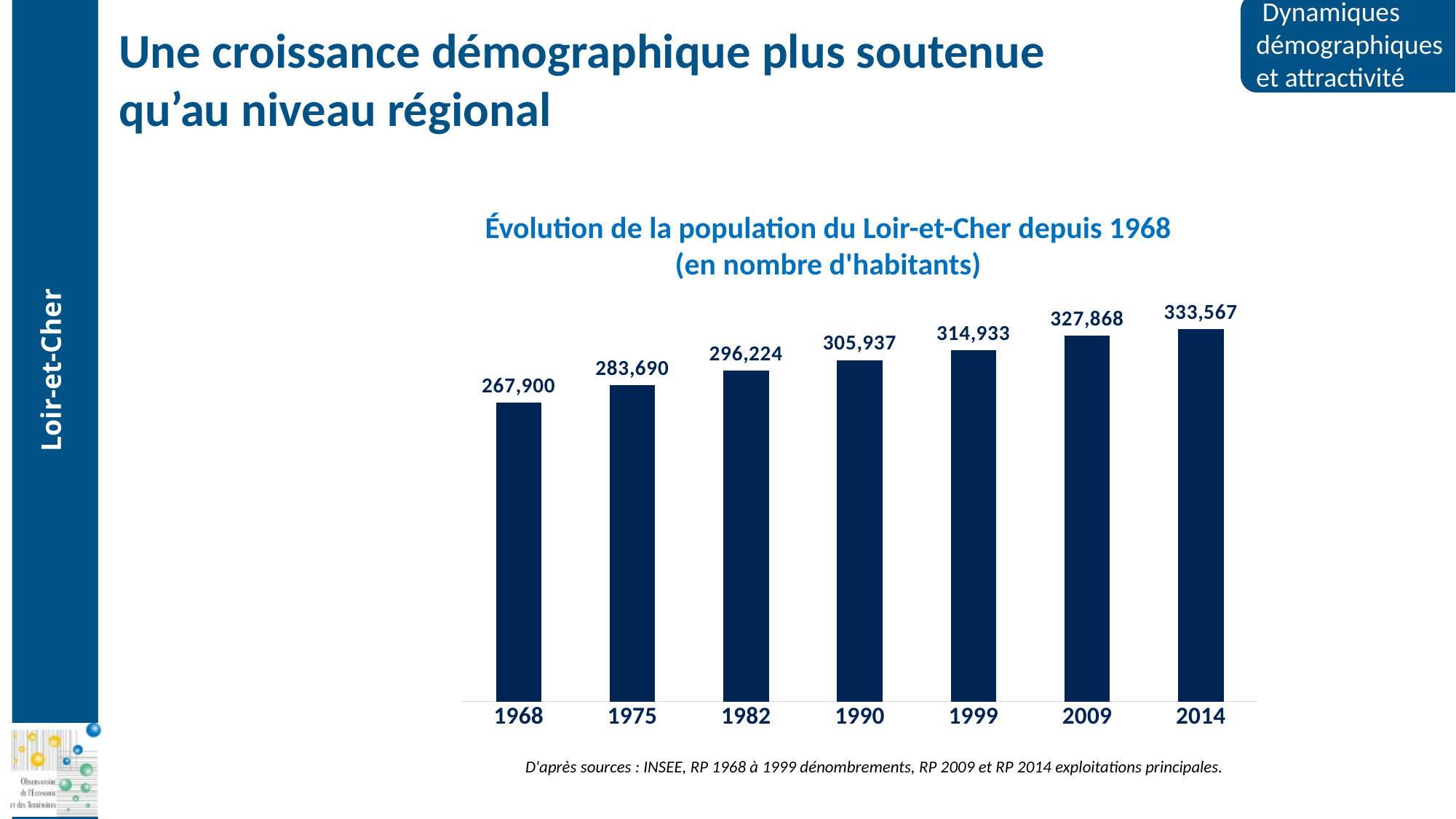
What is the difference in population between 2009 and 1999? 12,935 Does the population rise or fall from 1968 to 2014? Rise Which year has a larger population, 1982 or 1975? 1982 How many years are shown on the x axis of the chart? 7 What was the population of Loir-et-Cher in 1968? 267,900 What is the difference in population between 2014 and 1968? 65,667 Which year has the lowest population value on the chart? 1968 Which year has the highest population value on the chart? 2014 What was the population of Loir-et-Cher in 1990? 305,937 What was the population of Loir-et-Cher in 2014? 333,567 What is the title of the chart? Évolution de la population du Loir-et-Cher depuis 1968 (en nombre d'habitants) What kind of chart is shown on the slide? Bar chart